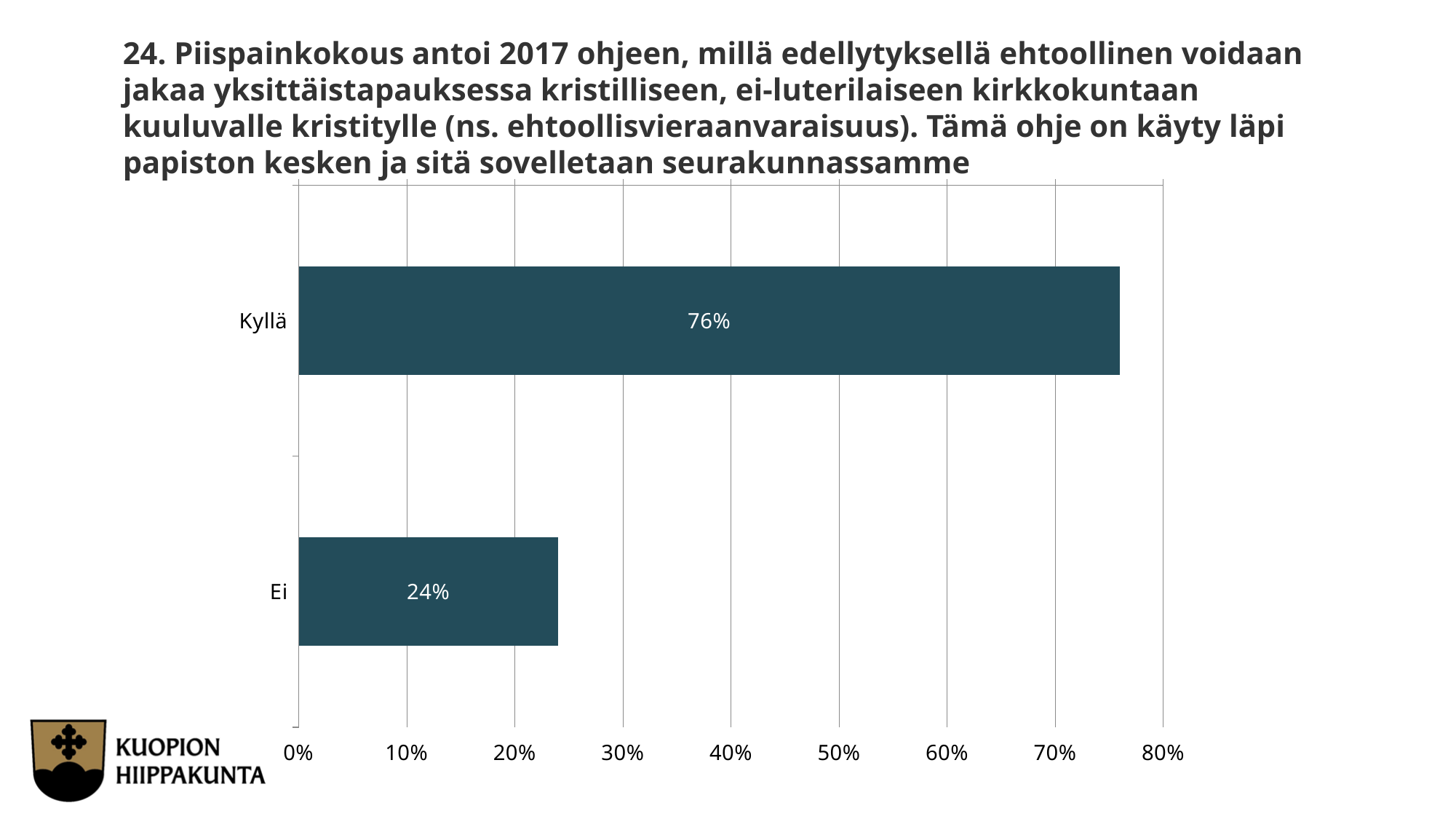
Which is larger, the value for Kyllä or the value for Ei? Kyllä What is the total of the values for Kyllä and Ei? 100% What kind of chart is shown on the slide? bar chart How many categories are shown in the chart? 2 What is the highest value shown on the x axis? 80% What is the value for Kyllä? 76% Is the value for Ei greater or less than 30%? less What is the difference between the values for Kyllä and Ei? 52% Which category has the highest value? Kyllä What is the value for Ei? 24% Which category has the lowest value? Ei Is the value for Kyllä greater or less than 70%? greater